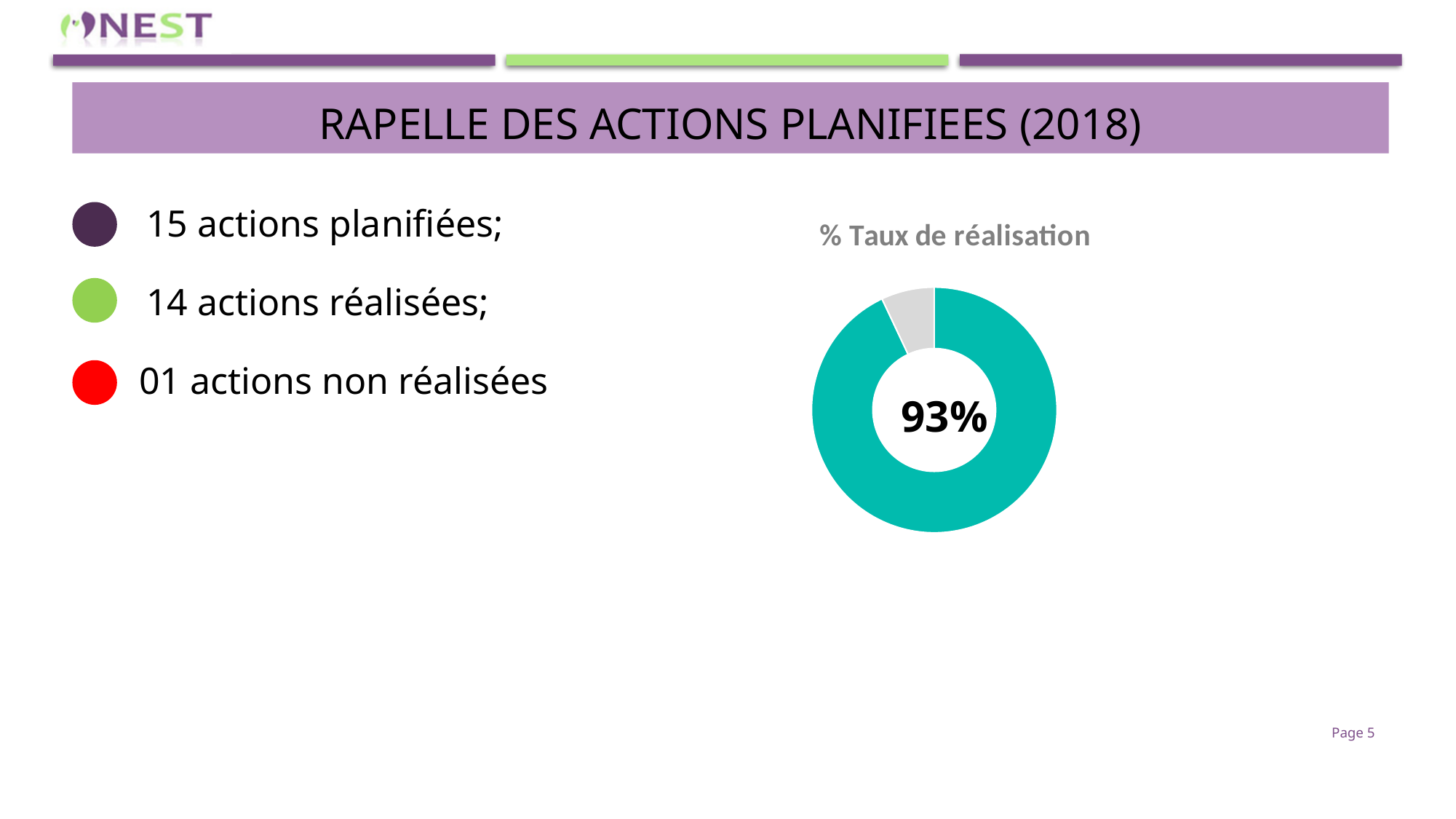
What percentage is displayed in the centre of the doughnut chart? 93% What is the title of the chart? % Taux de réalisation Which slice of the doughnut chart is larger, the teal one or the grey one? teal Does the doughnut chart display a legend? No What colour is the largest slice of the doughnut chart? teal Is the teal slice of the doughnut chart greater or less than 50%? greater What kind of chart is shown on the slide? doughnut chart How many slices does the doughnut chart have? 2